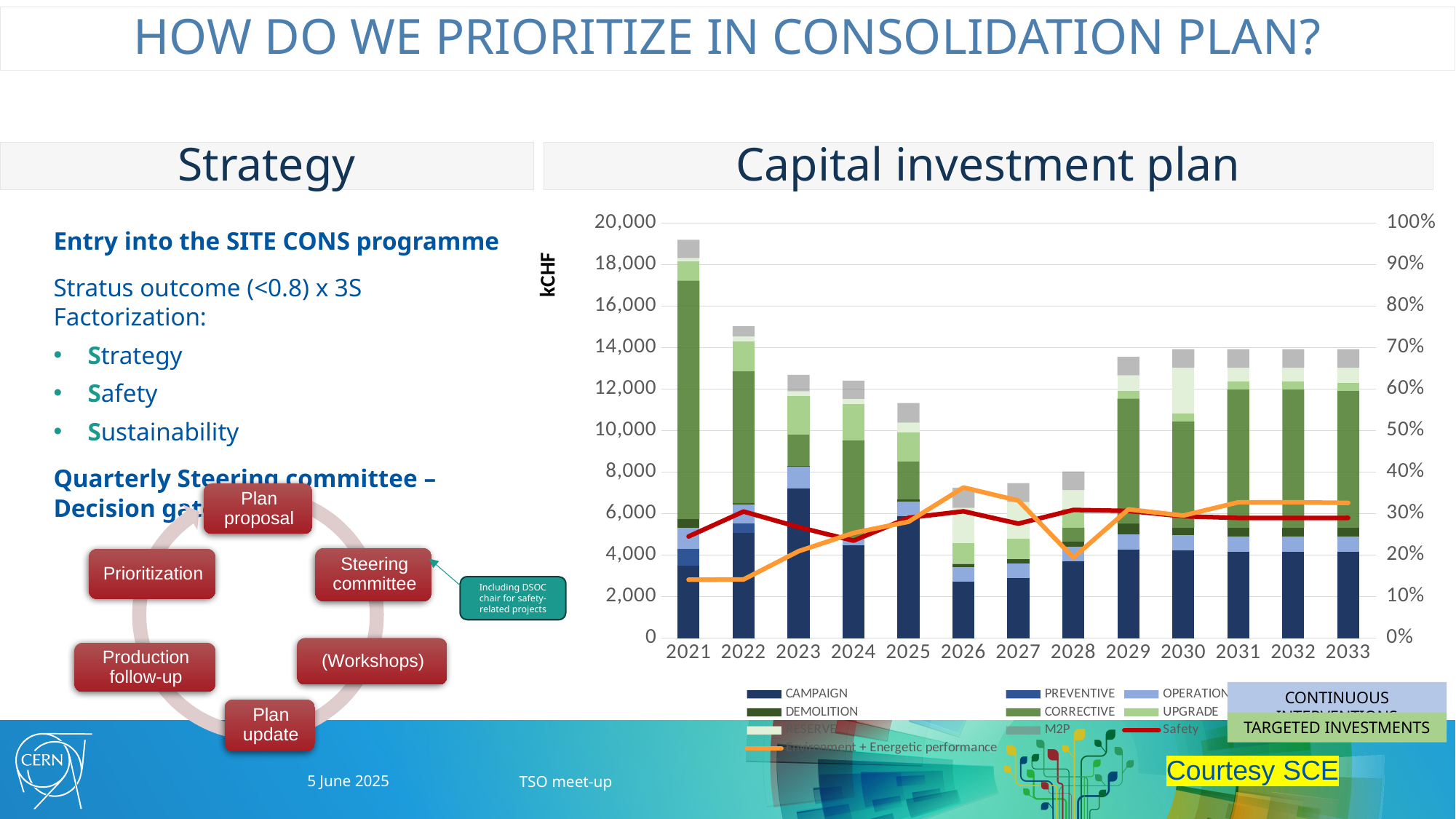
Is the total of the 2025 bar in the Capital investment plan chart greater or less than 12,000? less What colour is the Safety line in the Capital investment plan chart? red Do the stacked bar totals in the Capital investment plan chart rise or fall from 2021 to 2026? fall How many years are shown on the x axis of the Capital investment plan chart? 13 Is the total of the 2029 bar in the Capital investment plan chart greater or less than 12,000? greater How many series does the legend of the Capital investment plan chart list? 10 What kind of chart is the Capital investment plan chart? stacked bar chart with lines Is the total of the 2021 bar in the Capital investment plan chart greater or less than 18,000? greater In the Capital investment plan chart, which year has the larger total bar, 2022 or 2023? 2022 Which year has the tallest stacked bar in the Capital investment plan chart? 2021 What unit label is shown on the left vertical axis of the Capital investment plan chart? kCHF